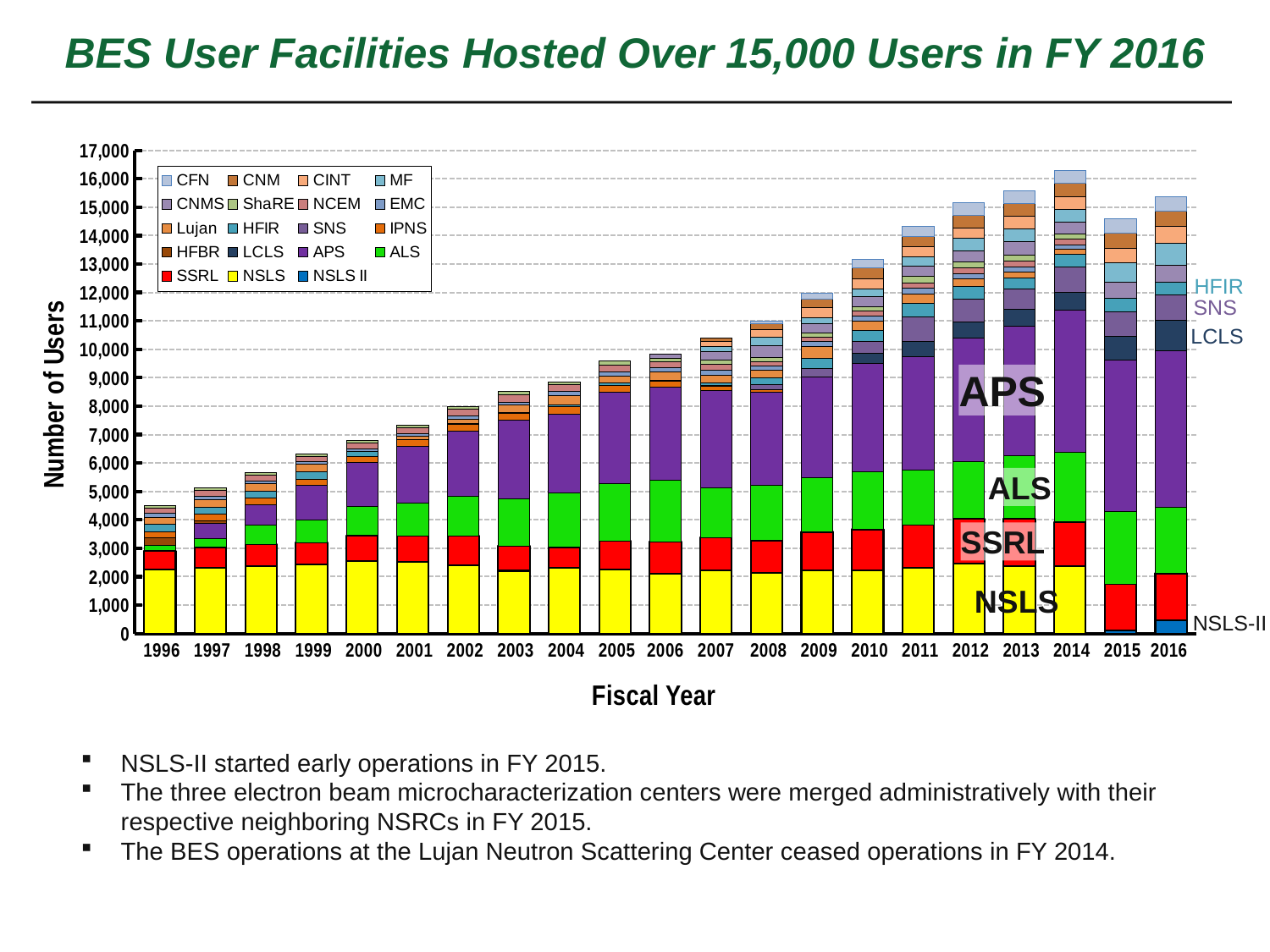
Is the total number of users for 2010 greater or less than 12,000? greater How many fiscal years are shown along the x axis of the chart? 21 Is the total number of users for 2016 greater or less than 15,000? greater What kind of chart is shown on the slide? Stacked bar chart Is the total number of users for 2015 greater or less than 15,000? less What is the label on the y axis of the chart? Number of Users Which fiscal year has a larger total number of users, 2015 or 2016? 2016 Does the total number of users generally rise or fall from 1996 to 2014? rise Which fiscal year has the highest total number of users? 2014 How many series does the chart's legend list? 19 Which fiscal year has the lowest total number of users? 1996